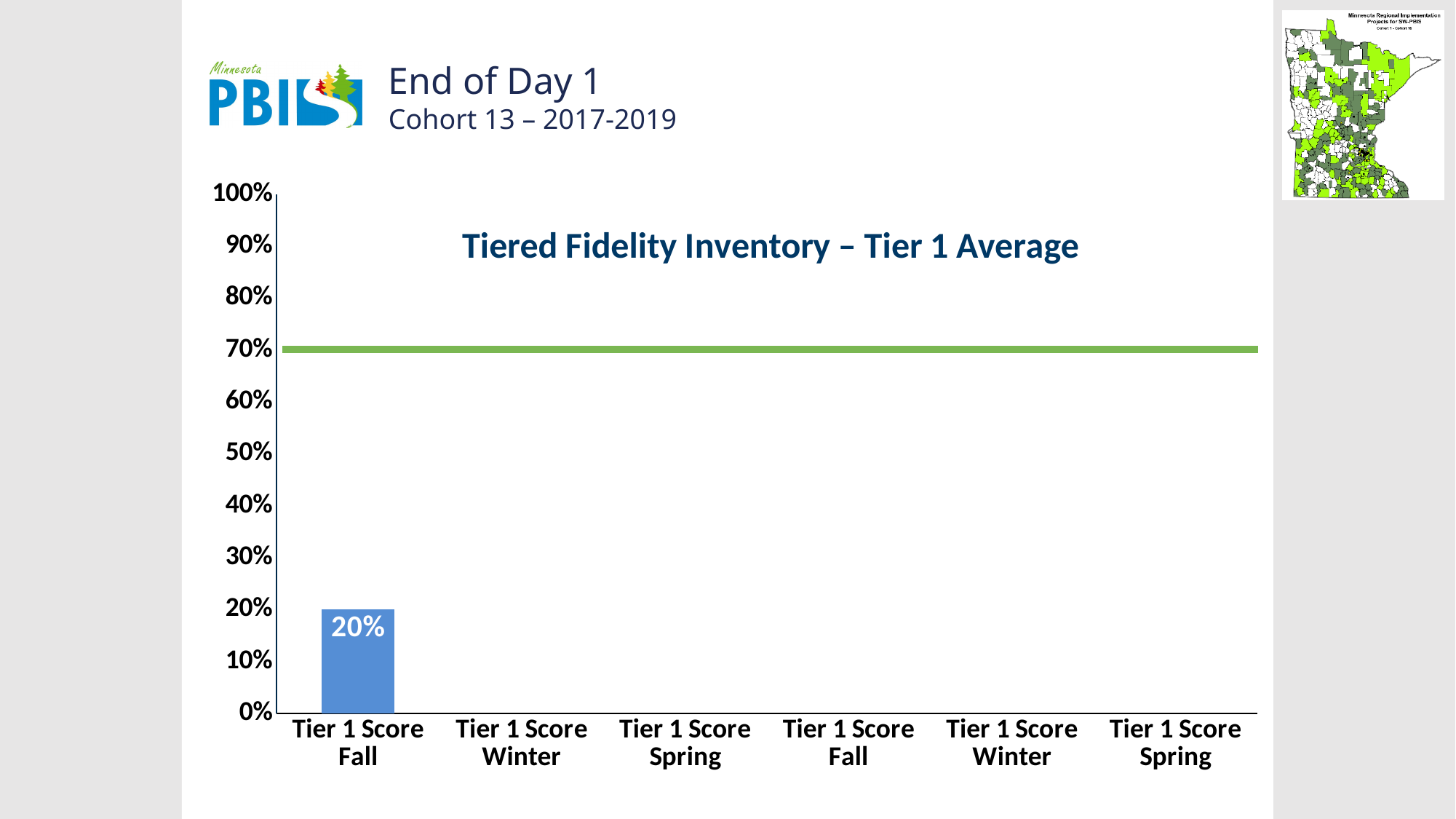
How many bars have a plotted value on the chart? 1 How many categories are shown along the x axis? 6 What is the difference between the green line value and the first Tier 1 Score Fall bar? 50% Which category has the only plotted bar? Tier 1 Score Fall (first) At what percentage is the green horizontal line drawn? 70% What is the value of the first Tier 1 Score Fall bar? 20% What kind of chart is shown on the slide? bar chart What is the highest value shown on the y axis? 100% Is the value for the first Tier 1 Score Fall bar greater or less than 30%? less Which is larger, the first Tier 1 Score Fall bar or the green line? the green line Is the value for the first Tier 1 Score Fall bar greater or less than 10%? greater What is the title of the chart? Tiered Fidelity Inventory – Tier 1 Average